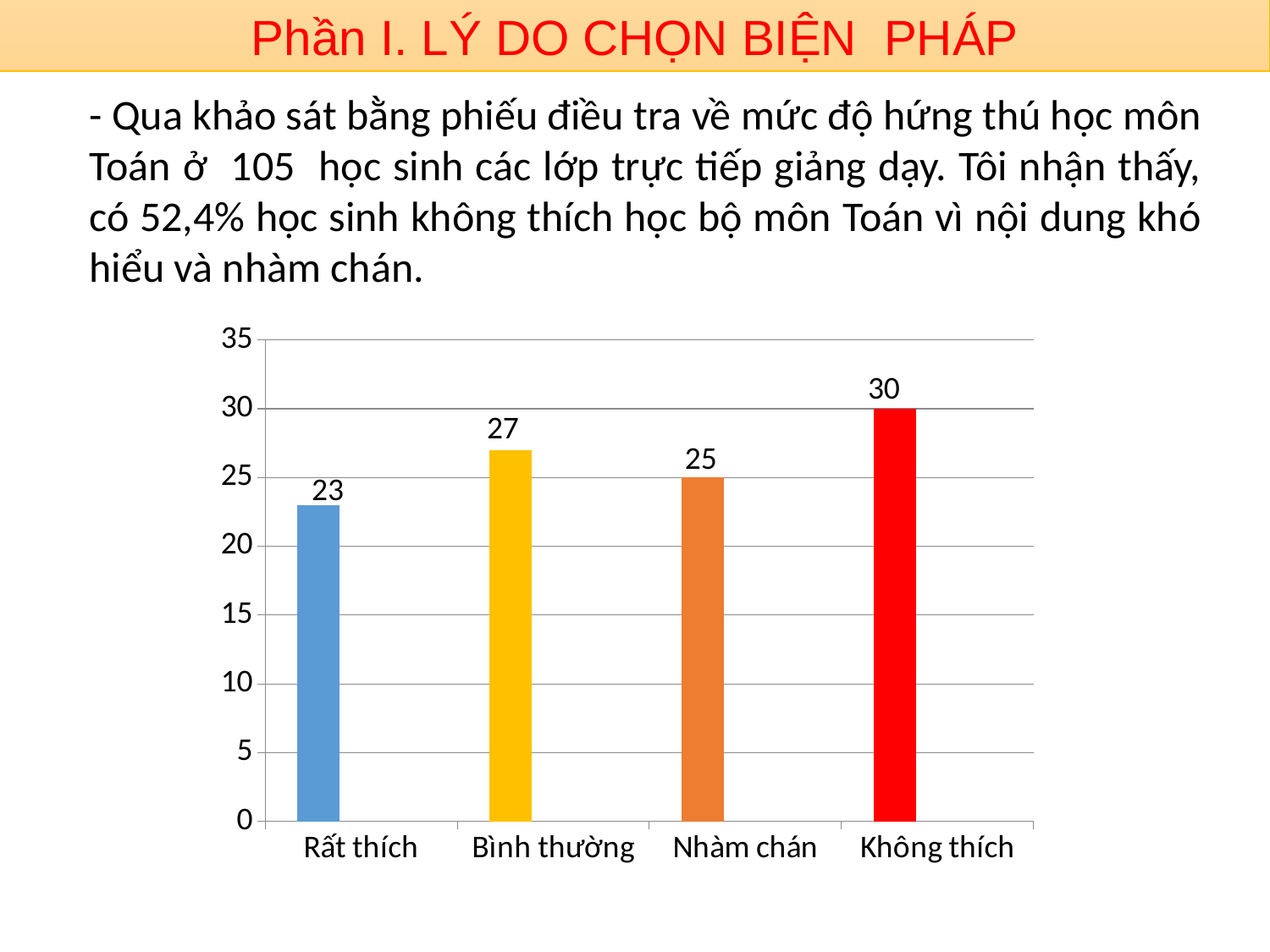
What is the value for Bình thường? 27 What is the value for Không thích? 30 What is the value for Nhàm chán? 25 Is the value for Rất thích greater or less than 25? less Which is larger, the value for Bình thường or the value for Nhàm chán? Bình thường What is the difference between the values for Không thích and Rất thích? 7 What is the difference between the values for Bình thường and Nhàm chán? 2 Which category has the highest value? Không thích What is the value for Rất thích? 23 Which category has the lowest value? Rất thích What kind of chart is shown on the slide? bar chart How many categories are shown on the chart? 4